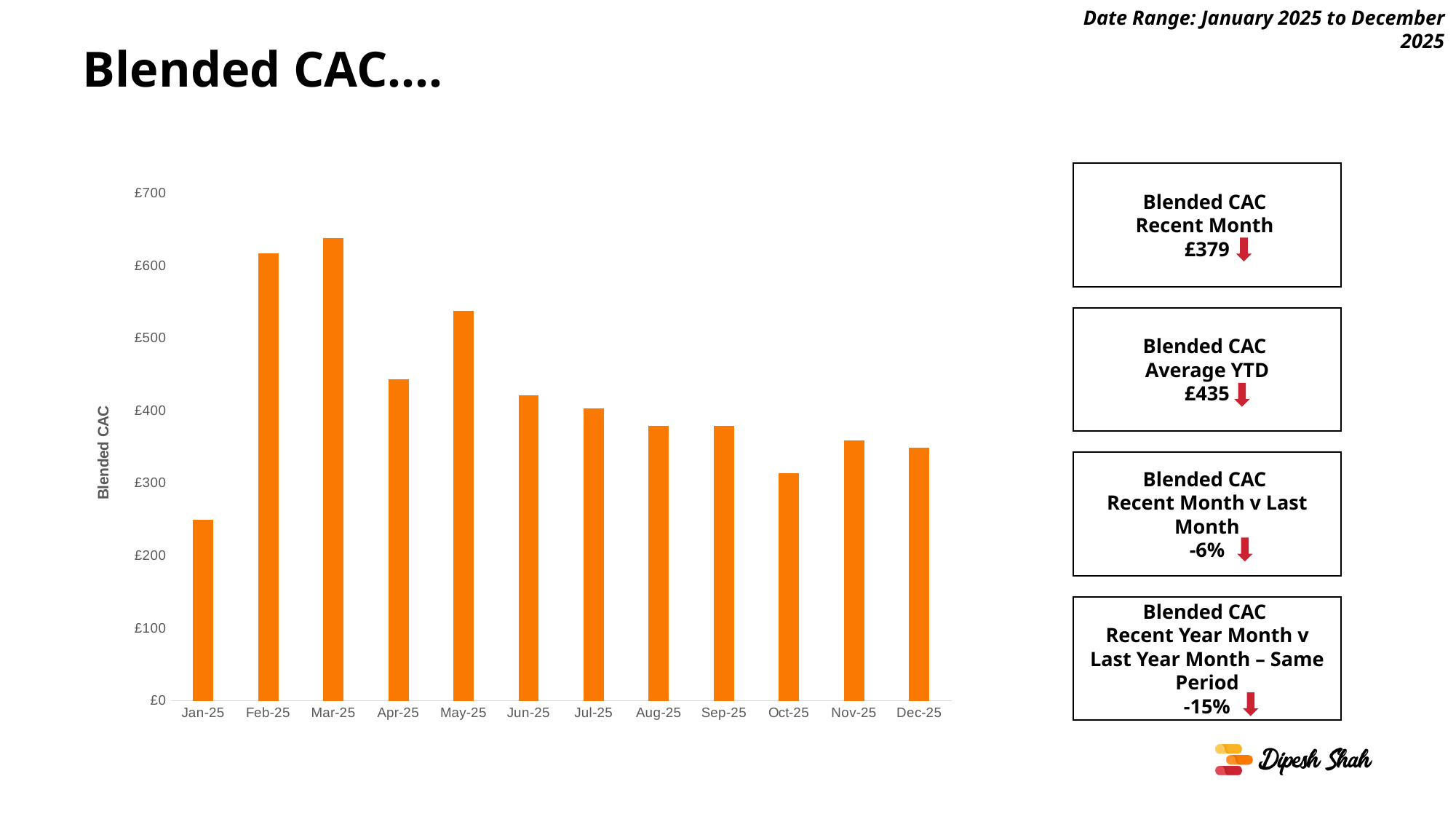
Is the Blended CAC for Jan-25 greater or less than £300? less Is the Blended CAC for May-25 greater or less than £500? greater Which month has the larger Blended CAC, Oct-25 or Nov-25? Nov-25 How many months are plotted on the x axis of the chart? 12 Is the Blended CAC for Dec-25 greater or less than £400? less Which month has the highest Blended CAC in the chart? Mar-25 From Mar-25 to Dec-25, does the Blended CAC generally rise or fall? fall What kind of chart is shown on the slide? bar chart Which month has the larger Blended CAC, Feb-25 or Apr-25? Feb-25 Which month has the lowest Blended CAC in the chart? Jan-25 What is the label on the vertical axis of the chart? Blended CAC